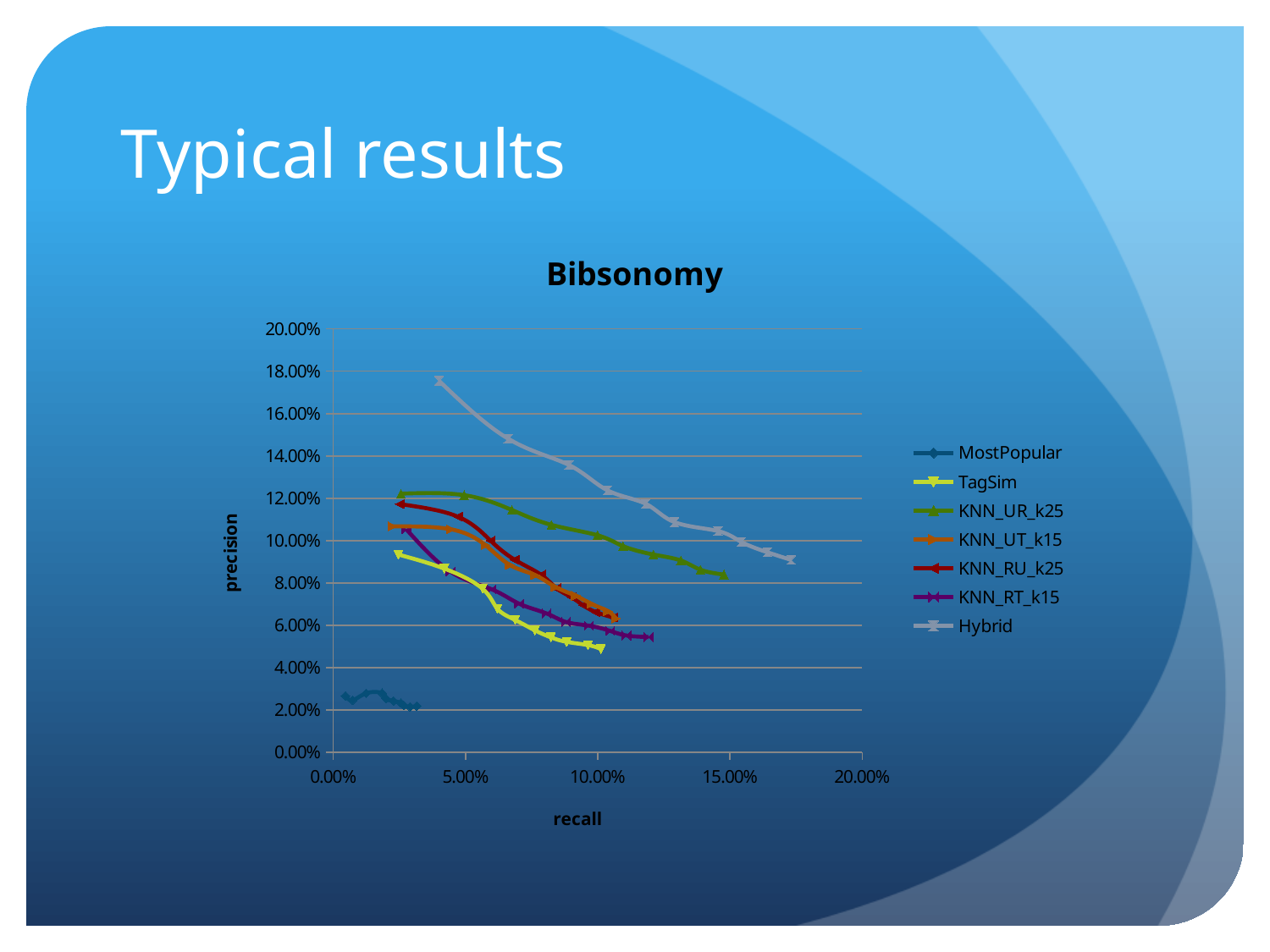
How many series does the legend of the Bibsonomy chart list? 7 What are the labels of the x axis and the y axis of the chart? recall (x axis) and precision (y axis) Is the highest precision value of the Hybrid series greater or less than 16.00%? greater What kind of chart is shown on the slide? line chart What is the title of the chart? Bibsonomy At a recall of about 10.00%, which series has the higher precision, KNN_UR_k25 or TagSim? KNN_UR_k25 Are the precision values of the MostPopular series greater or less than 4.00%? less As recall increases along the x axis, does the precision of the Hybrid series rise or fall? fall Which series reaches the highest precision on the chart? Hybrid Is the highest precision value of the KNN_UR_k25 series greater or less than 10.00%? greater Which series has the lowest precision values on the chart? MostPopular